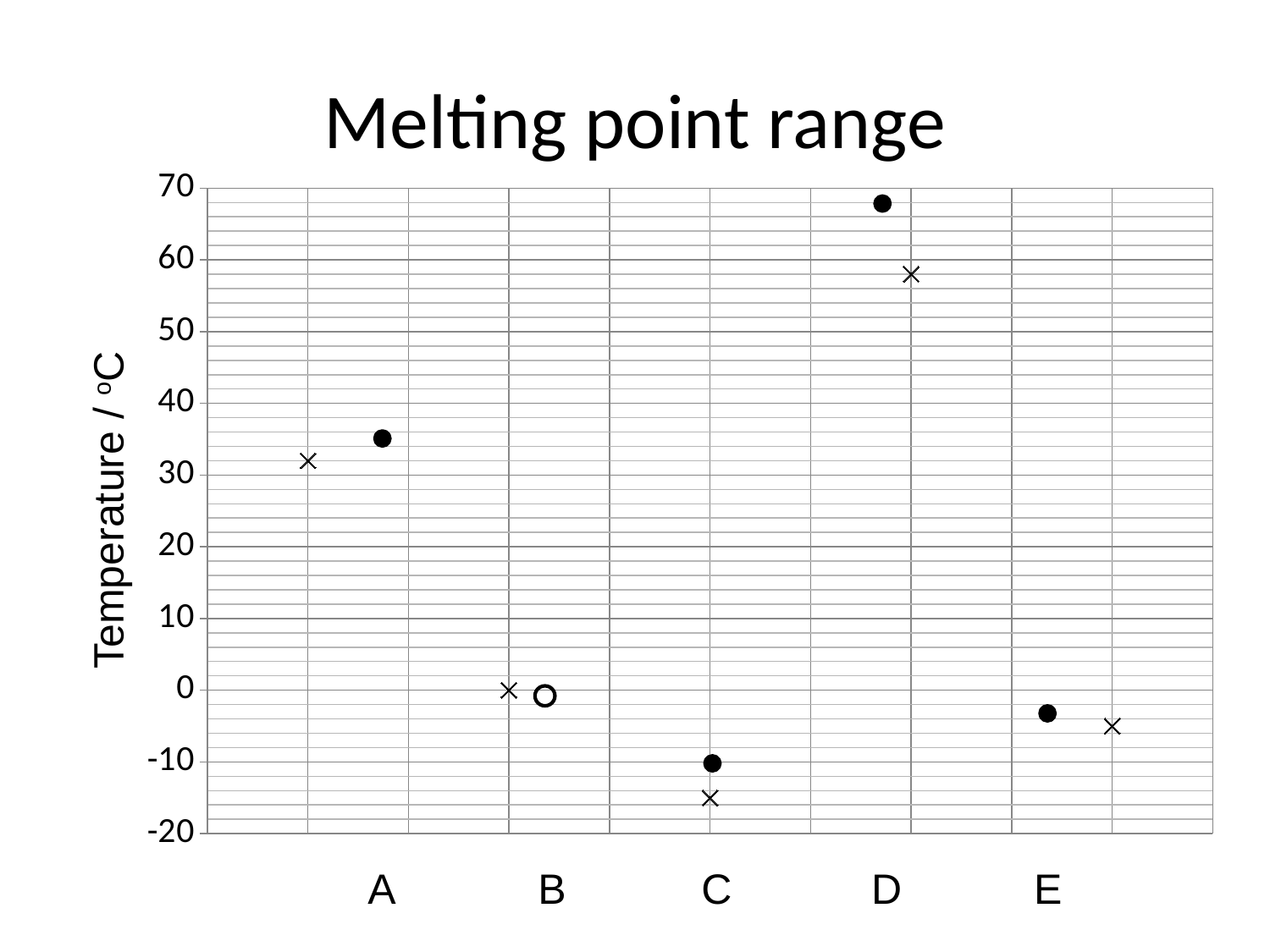
Is the value of the filled circle marker for D greater or less than 60? greater How many categories are shown along the horizontal axis? 5 Is the value of the filled circle marker for E greater or less than 0? less Which has the lower plotted temperature, the cross marker for C or the cross marker for E? C What is the title of the chart? Melting point range Which has the higher plotted temperature, the filled circle marker for D or the filled circle marker for A? D Which category has the highest plotted temperature? D Which category has the lowest plotted temperature? C Is the value of the filled circle marker for A greater or less than 30? greater What is the label on the vertical axis? Temperature / °C What kind of chart is shown on the slide? scatter chart